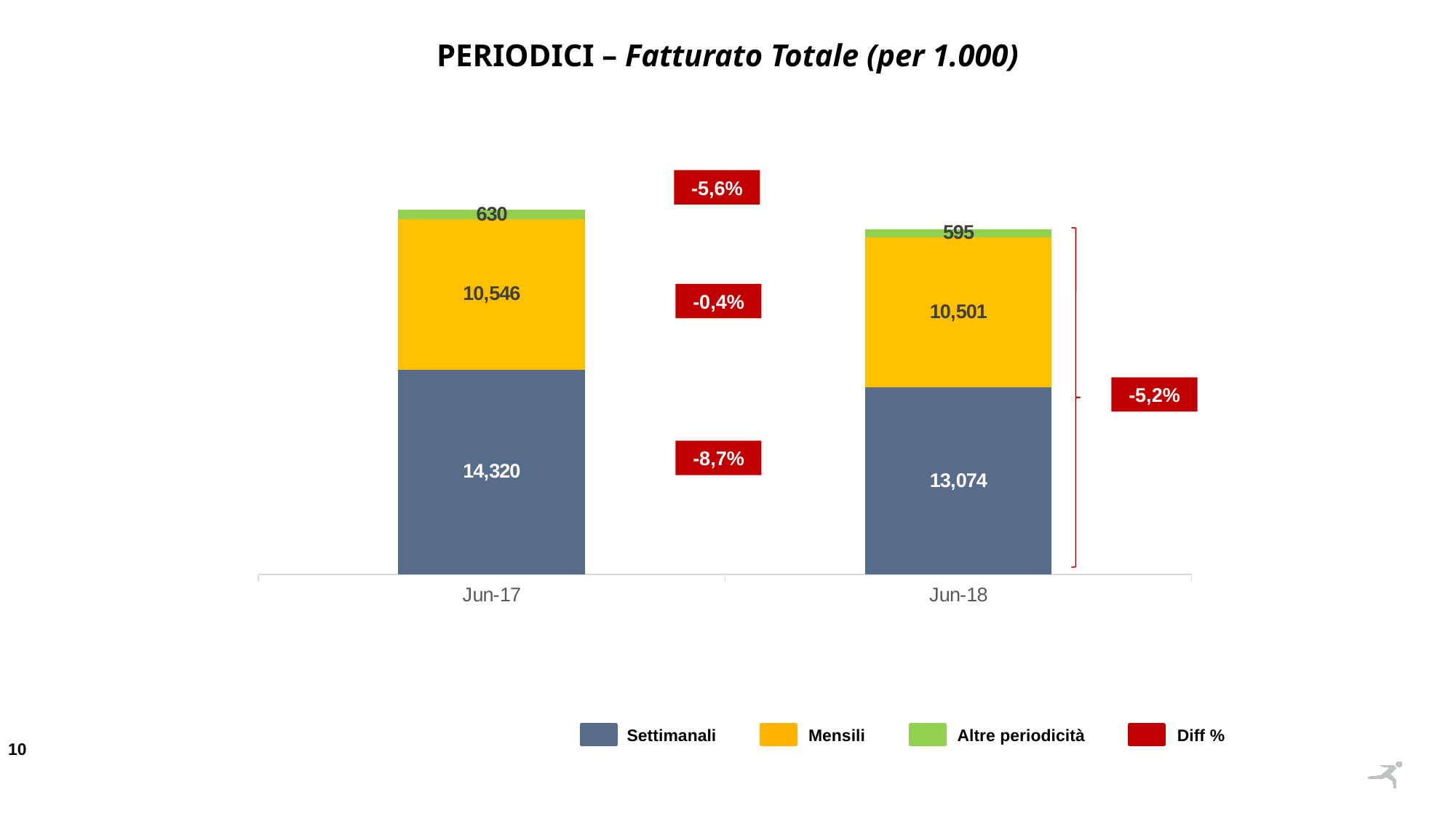
What is the value for Altre periodicità in Jun-17? 630 What is the value for Settimanali in Jun-17? 14,320 What is the value for Mensili in Jun-18? 10,501 Which series has the largest value in Jun-18? Settimanali Is the Mensili value larger in Jun-17 or Jun-18? Jun-17 What type of chart is shown on the slide? Stacked bar chart What is the total of the stacked bar for Jun-18? 24,170 How many series does the legend list? 4 What is the difference between the Settimanali values for Jun-17 and Jun-18? 1,246 What is the Diff % shown for Settimanali between Jun-17 and Jun-18? -8,7% Which series has the smallest value in Jun-17? Altre periodicità What is the overall Diff % shown for the total between Jun-17 and Jun-18? -5,2%